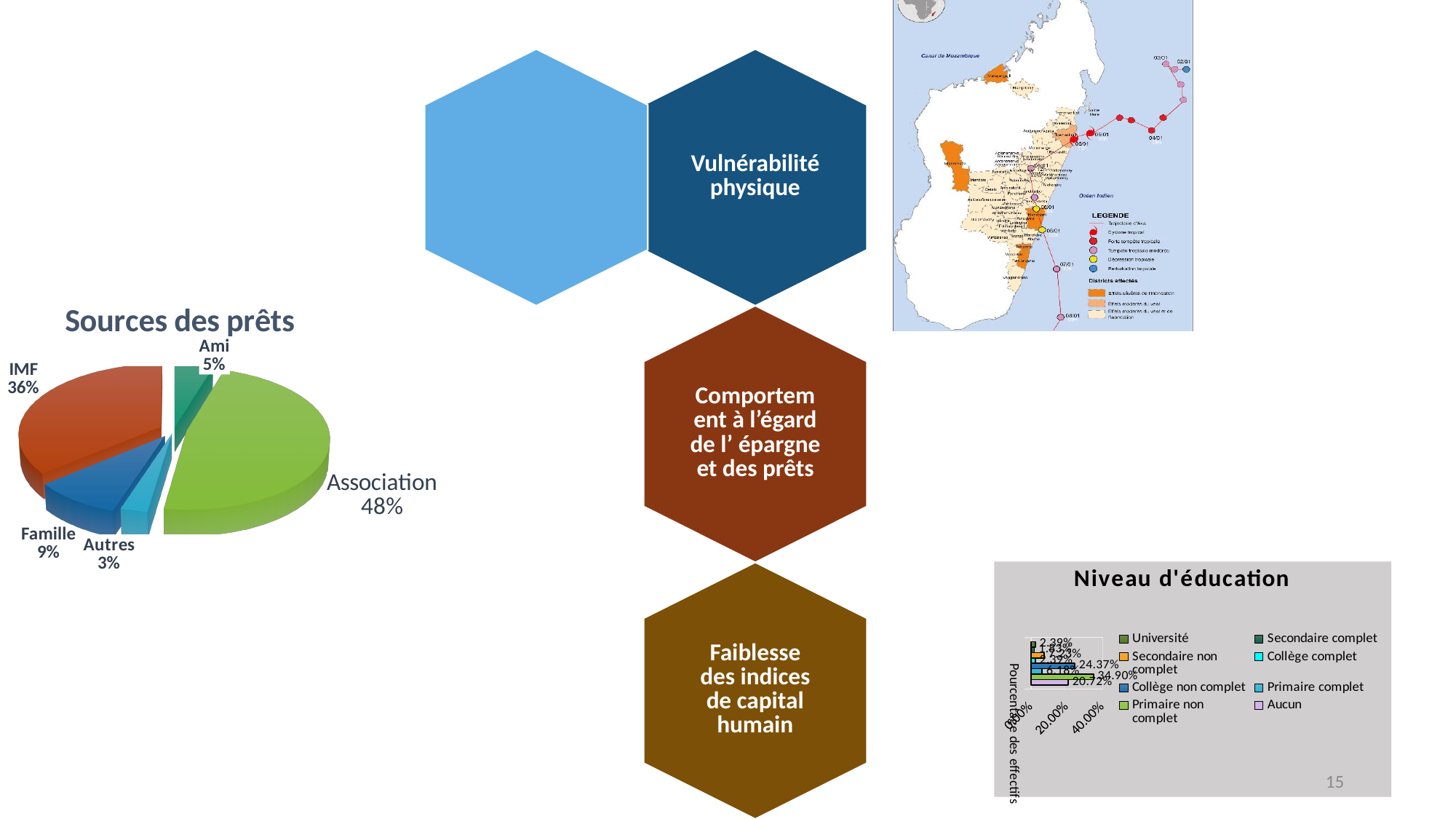
In the 'Sources des prêts' pie chart, what share of loans comes from Association? 48% What kind of chart is 'Niveau d'éducation'? Bar chart How many categories are shown in the 'Sources des prêts' pie chart? 5 In the 'Sources des prêts' pie chart, which source has the smallest share? Autres In the 'Sources des prêts' pie chart, what percentage is shown for IMF? 36% In the 'Sources des prêts' pie chart, how many percentage points larger is Association than IMF? 12 percentage points What kind of chart is 'Sources des prêts'? Pie chart In the 'Sources des prêts' pie chart, which source has the largest share? Association How many entries does the legend of the 'Niveau d'éducation' chart list? 8 In the 'Sources des prêts' pie chart, what percentage is shown for Ami? 5% In the 'Sources des prêts' pie chart, which is larger, Famille or Ami? Famille In the 'Sources des prêts' pie chart, what percentage is shown for Famille? 9%